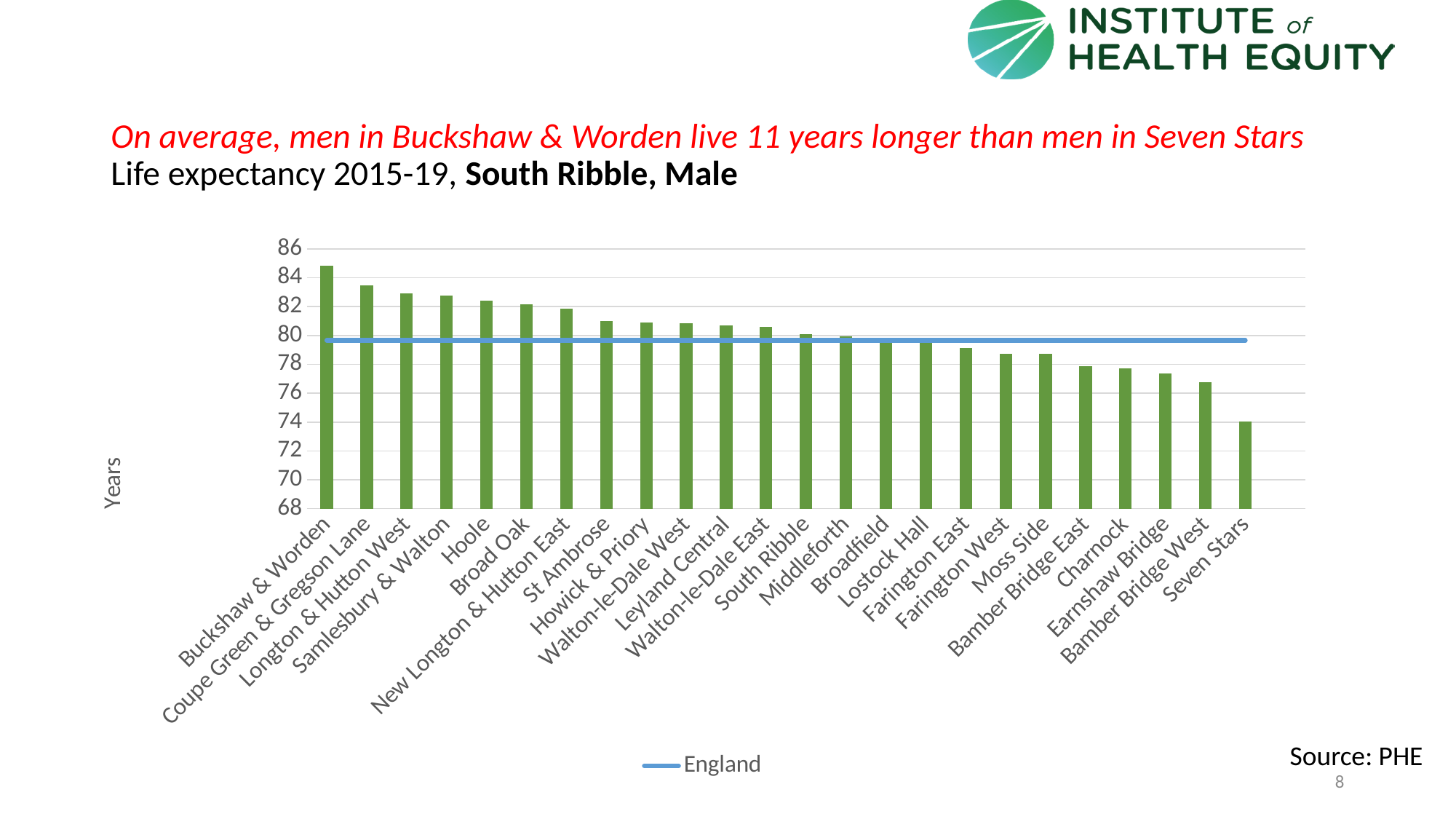
Is the value for Buckshaw & Worden greater or less than 82? greater How many entries does the chart legend list? 1 Which has the larger value, Hoole or Charnock? Hoole What is the label on the vertical axis of the chart? Years How many areas are plotted as bars in the chart? 24 Which area has the highest male life expectancy in the chart? Buckshaw & Worden Which area has the lowest male life expectancy in the chart? Seven Stars Do the bar values rise or fall from left to right along the x axis? fall What kind of chart is shown on the slide? bar chart Is the value for Hoole greater or less than 80? greater Is the value for Moss Side greater or less than 80? less